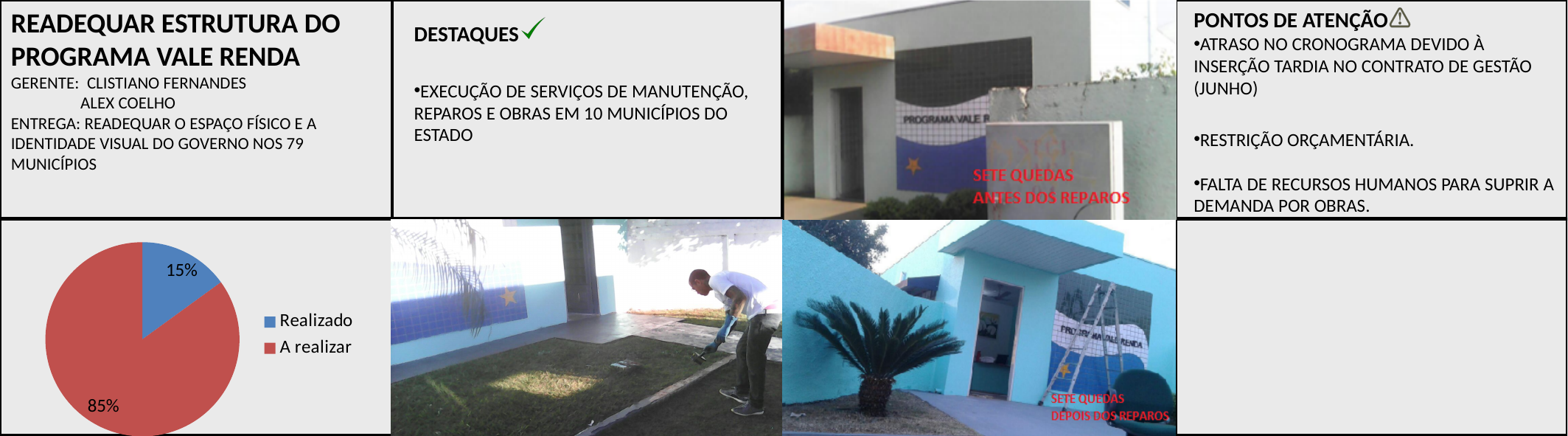
What is the difference in percentage points between "A realizar" and "Realizado"? 70 What share of the pie does "A realizar" represent? 85% How many slices does the pie chart have? 2 Which slice of the pie chart is the largest? A realizar Which is larger, "Realizado" or "A realizar"? A realizar What kind of chart is shown on the slide? pie chart What colour is the "A realizar" slice in the pie chart? red What share of the pie does "Realizado" represent? 15% Which slice of the pie chart is the smallest? Realizado How many entries does the legend of the pie chart list? 2 What colour is the "Realizado" slice in the pie chart? blue